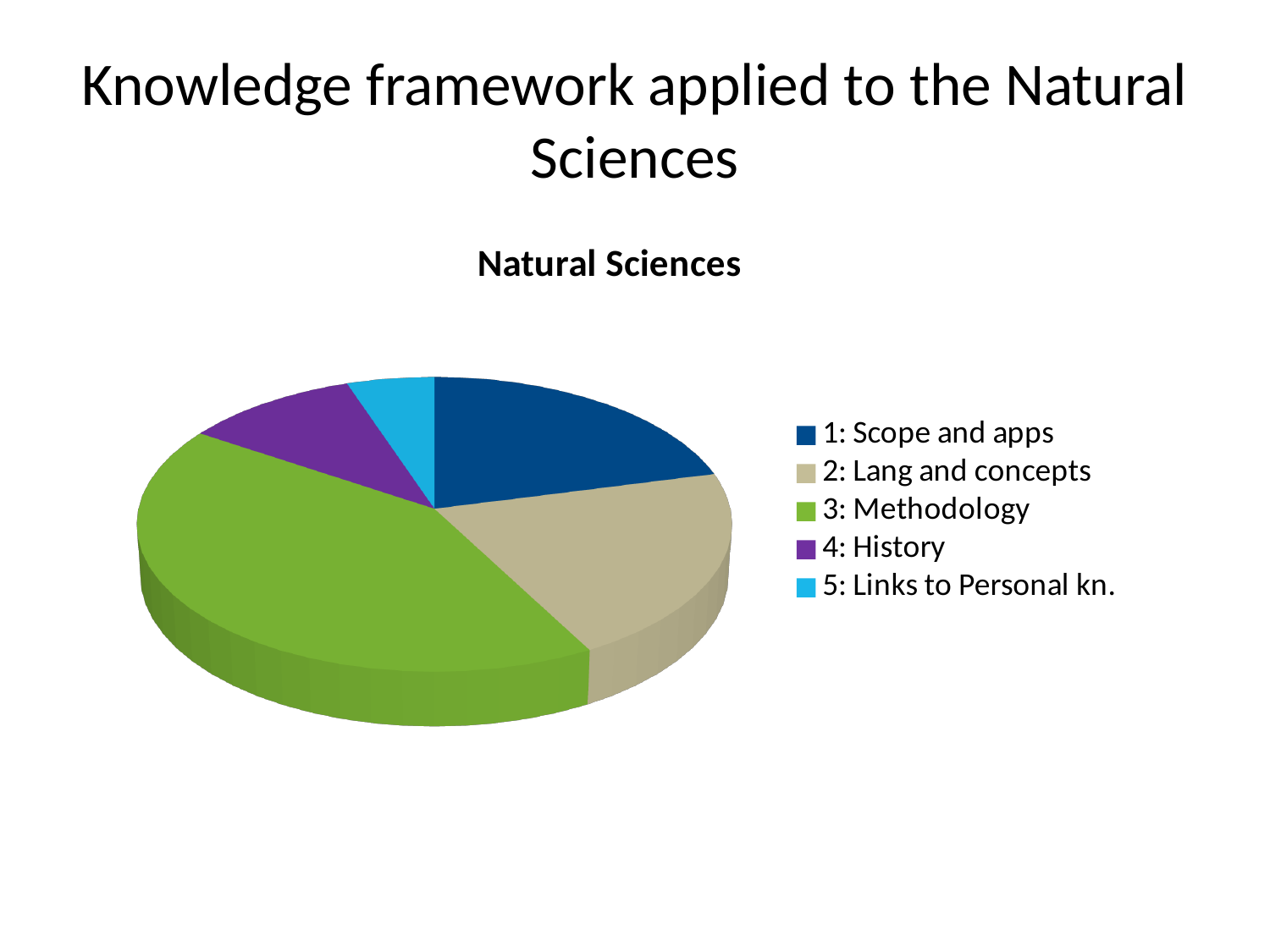
What kind of chart is shown on the slide? Pie chart Which slice is larger, 4: History or 5: Links to Personal kn.? 4: History Which slice is larger, 2: Lang and concepts or 4: History? 2: Lang and concepts Which colour represents 3: Methodology in the legend? Green What is the title of the chart? Natural Sciences Which category has the largest slice in the Natural Sciences pie chart? 3: Methodology How many slices does the Natural Sciences pie chart have? 5 Which slice is larger, 1: Scope and apps or 4: History? 1: Scope and apps Which category has the smallest slice in the Natural Sciences pie chart? 5: Links to Personal kn.